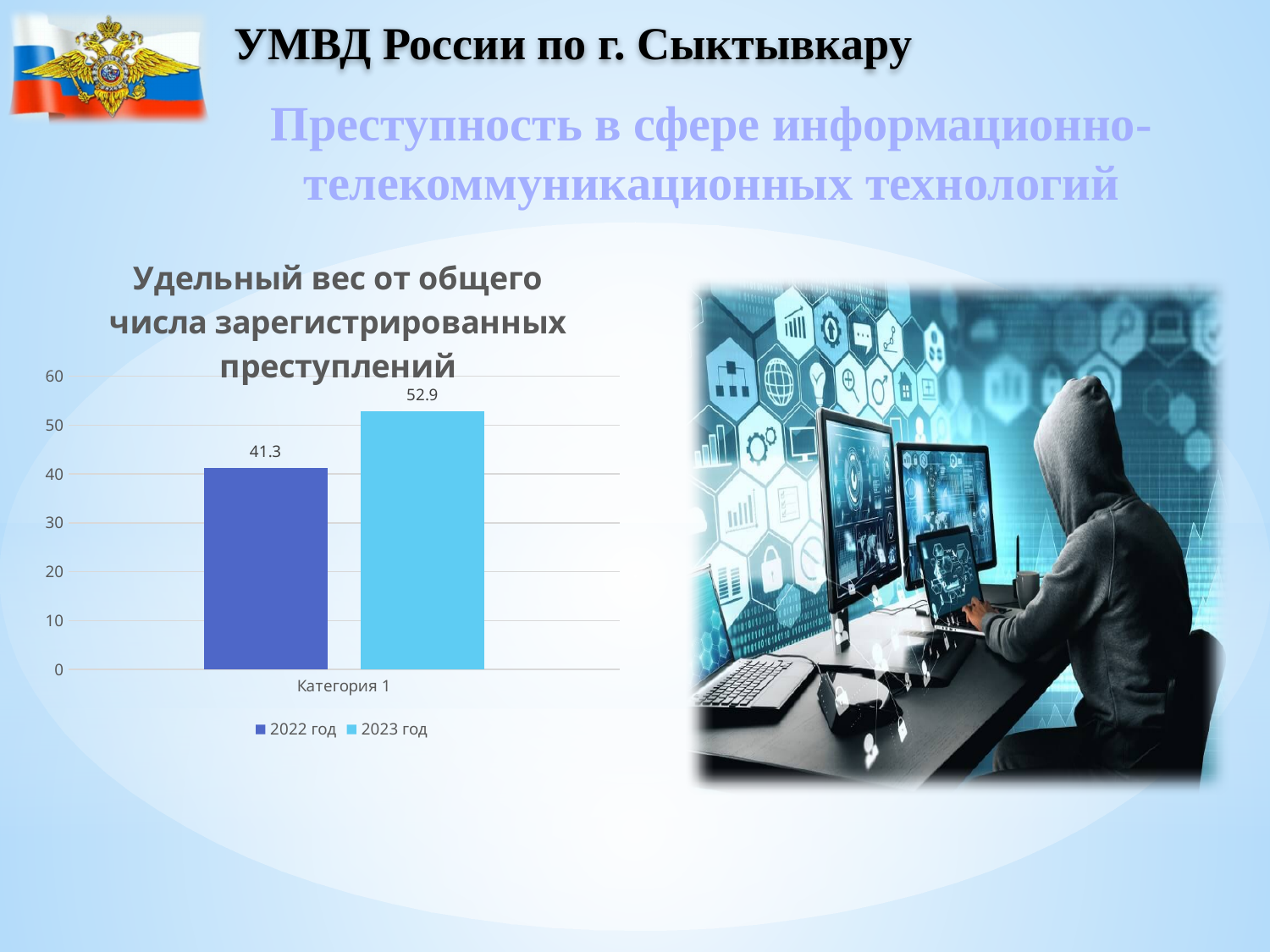
What is the value for 2023 год in the chart? 52.9 What kind of chart is shown on the slide? bar chart Which series has the higher value, 2022 год or 2023 год? 2023 год What is the title of the chart? Удельный вес от общего числа зарегистрированных преступлений What is the maximum value shown on the y axis of the chart? 60 What is the difference between the 2023 год and 2022 год values? 11.6 How many series does the legend list? 2 What is the value for 2022 год in the chart? 41.3 Which series has the lowest value in the chart? 2022 год Is the value for 2023 год greater or less than 60? less What is the category label shown on the x axis of the chart? Категория 1 Is the value for 2022 год greater or less than 40? greater